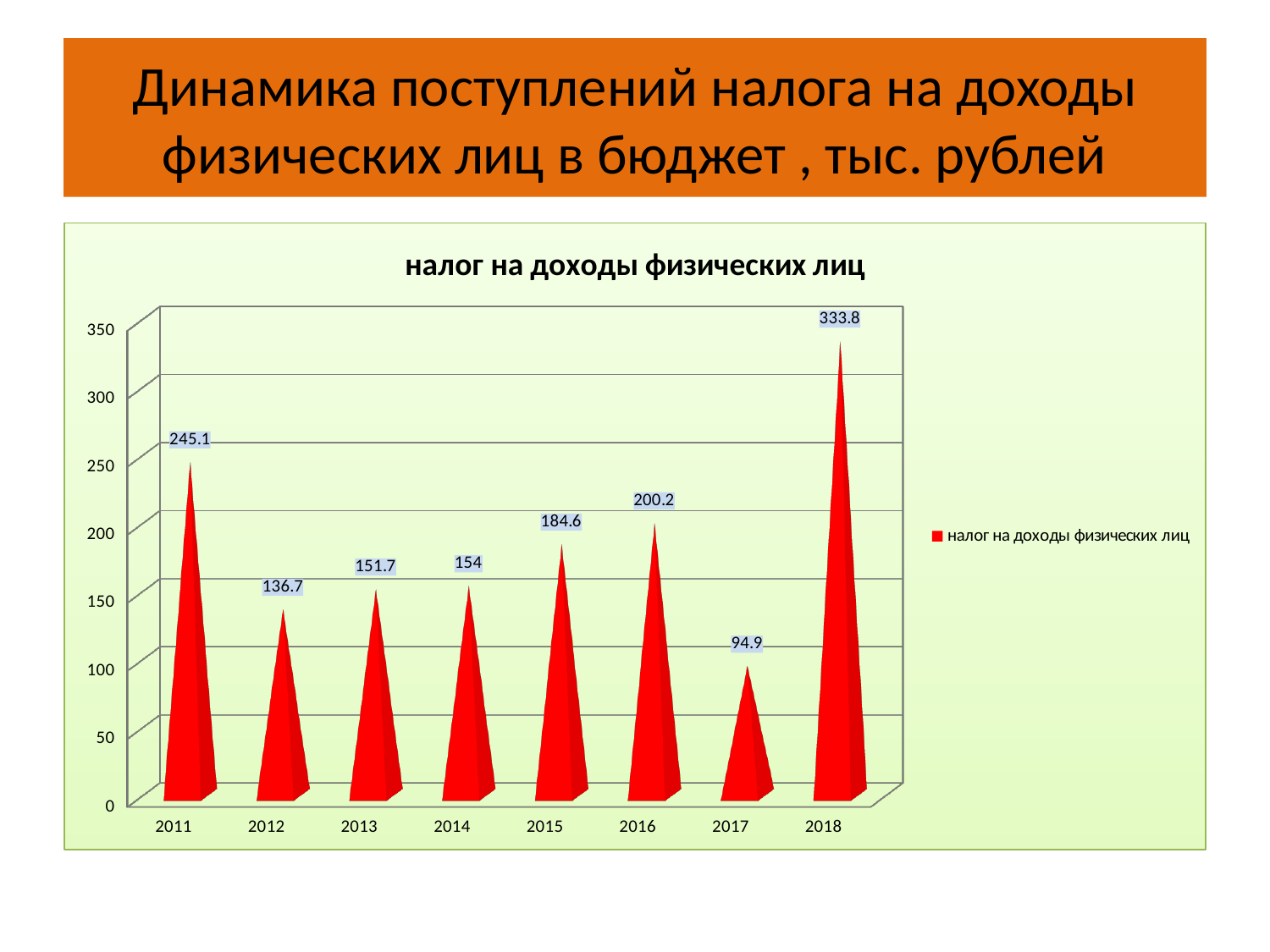
How many years are shown on the x axis? 8 What is the value for 2018? 333.8 How many series does the legend list? 1 What is the value for 2017? 94.9 What is the difference between the values for 2016 and 2015? 15.6 What is the value for 2011? 245.1 What is the value for 2014? 154 Which year has the lowest value? 2017 Which is larger, the value for 2012 or the value for 2013? 2013 Which year has the highest value? 2018 What is the title of the chart? налог на доходы физических лиц What is the difference between the values for 2018 and 2017? 238.9